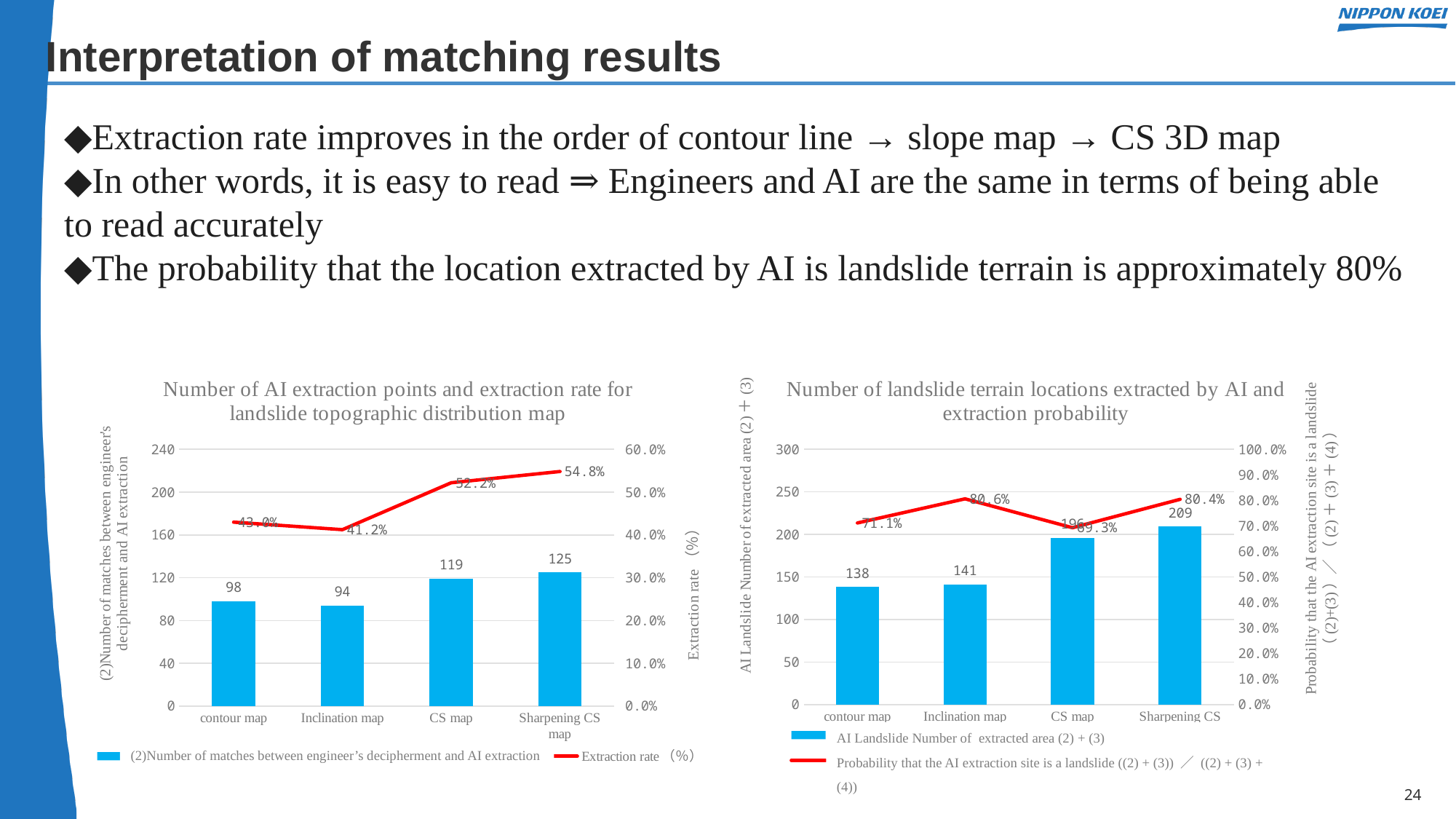
In the left chart, what is the extraction rate for the Sharpening CS map? 54.8% In the right chart, what is the probability that the AI extraction site is a landslide for the contour map? 71.1% How many series does the legend of the right chart list? 2 In the right chart, which is larger: the extraction probability for the Inclination map or for the Sharpening CS map? Inclination map In the right chart, what is the difference in extracted locations between the CS map and the contour map? 58 In the left chart, what is the extraction rate for the Inclination map? 41.2% In the right chart, which map has the highest number of extracted landslide locations? Sharpening CS In the left chart, which map has the lowest number of matches between engineer's decipherment and AI extraction? Inclination map How many categories are shown on the x axis of the left chart? 4 In the left chart, 'Number of AI extraction points and extraction rate for landslide topographic distribution map', what is the number of matches for the CS map? 119 In the left chart, what is the difference in number of matches between the Sharpening CS map and the contour map? 27 In the right chart, 'Number of landslide terrain locations extracted by AI and extraction probability', what is the AI landslide number of extracted area for the Sharpening CS map? 209